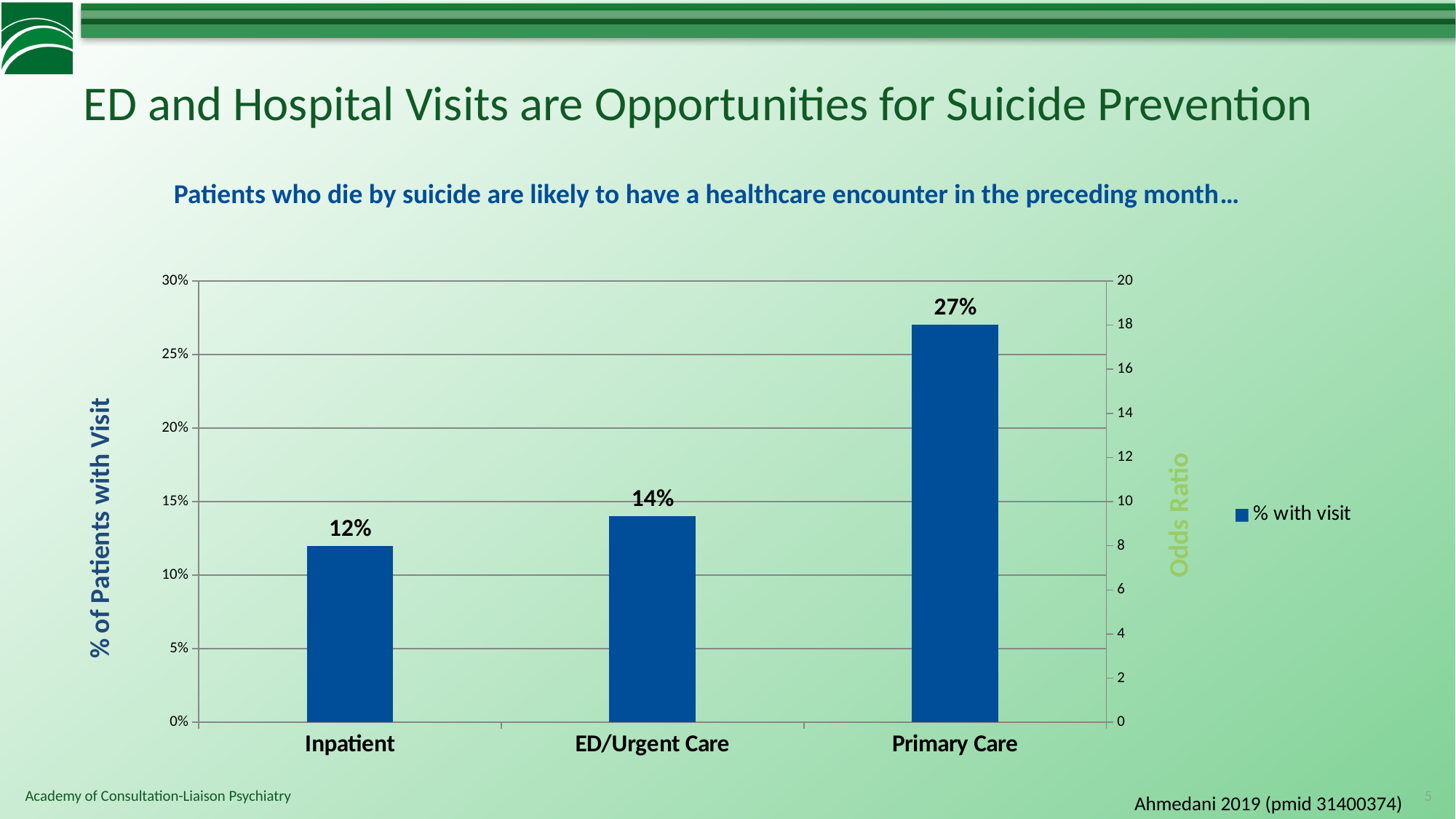
What is the label of the left vertical axis? % of Patients with Visit How many categories are shown on the x axis? 3 What is the value for Primary Care? 27% What is the difference between the Primary Care and Inpatient values? 15% Is the value for Primary Care greater or less than 25%? greater What is the value for Inpatient? 12% What kind of chart is shown on the slide? bar chart Which category has the lowest percentage of patients with a visit? Inpatient Which category has the highest percentage of patients with a visit? Primary Care What is the difference between the ED/Urgent Care and Inpatient values? 2% What is the value for ED/Urgent Care? 14% Which is larger, the value for Primary Care or the value for ED/Urgent Care? Primary Care